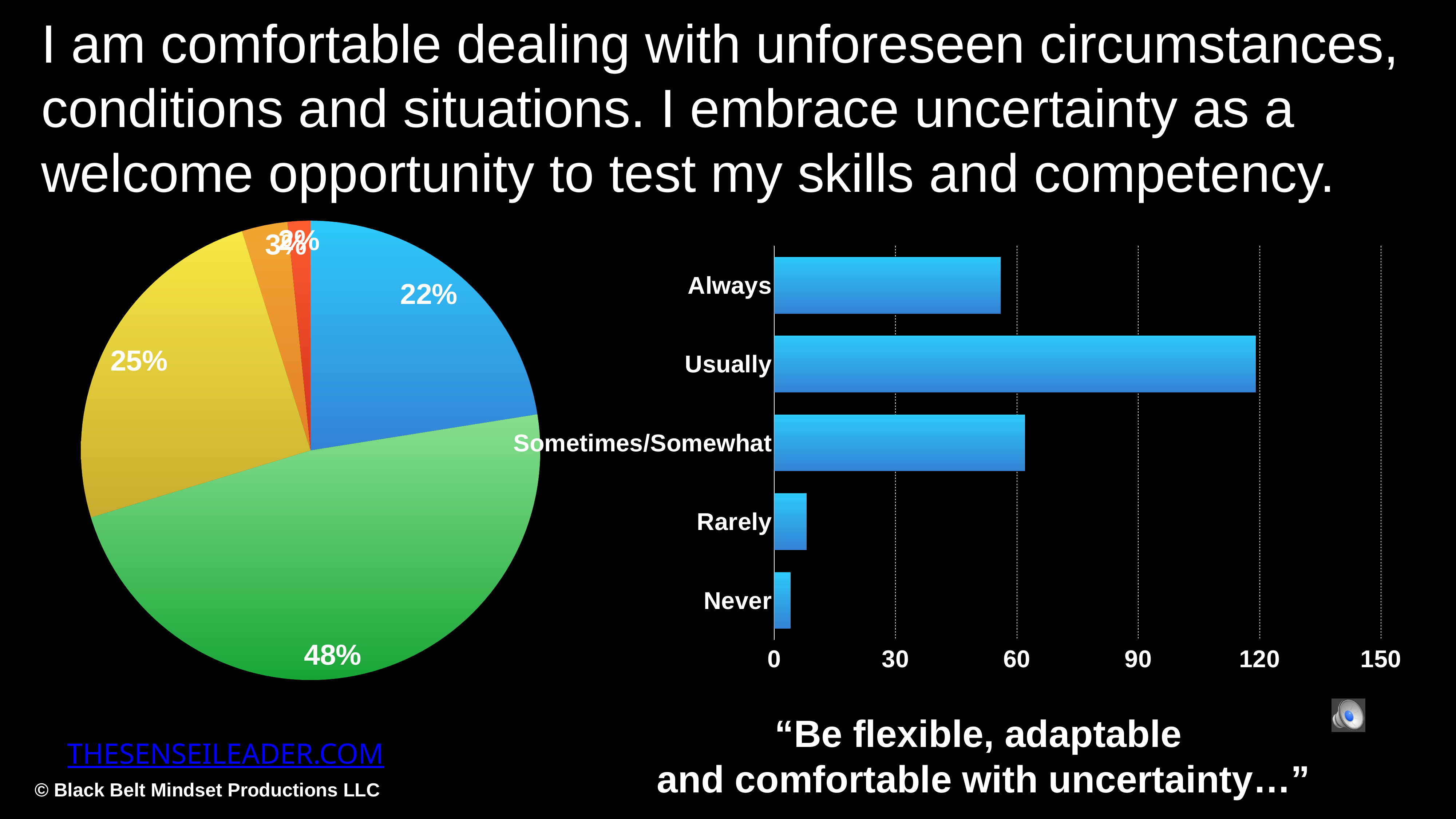
In the bar chart on the right, which is larger, the value for Usually or the value for Always? Usually What type of chart is shown on the right side of the slide? bar chart In the pie chart on the left, what percentage is shown on the green slice? 48% In the pie chart on the left, which is larger, the yellow slice or the blue slice? yellow slice What type of chart is shown on the left side of the slide? pie chart In the bar chart on the right, is the value for Usually greater or less than 90? greater How many categories are shown in the bar chart on the right? 5 In the pie chart on the left, what percentage is shown on the blue slice? 22% In the bar chart on the right, which category has the highest value? Usually In the bar chart on the right, which category has the lowest value? Never In the bar chart on the right, is the value for Rarely greater or less than 30? less In the bar chart on the right, is the value for Always greater or less than 60? less